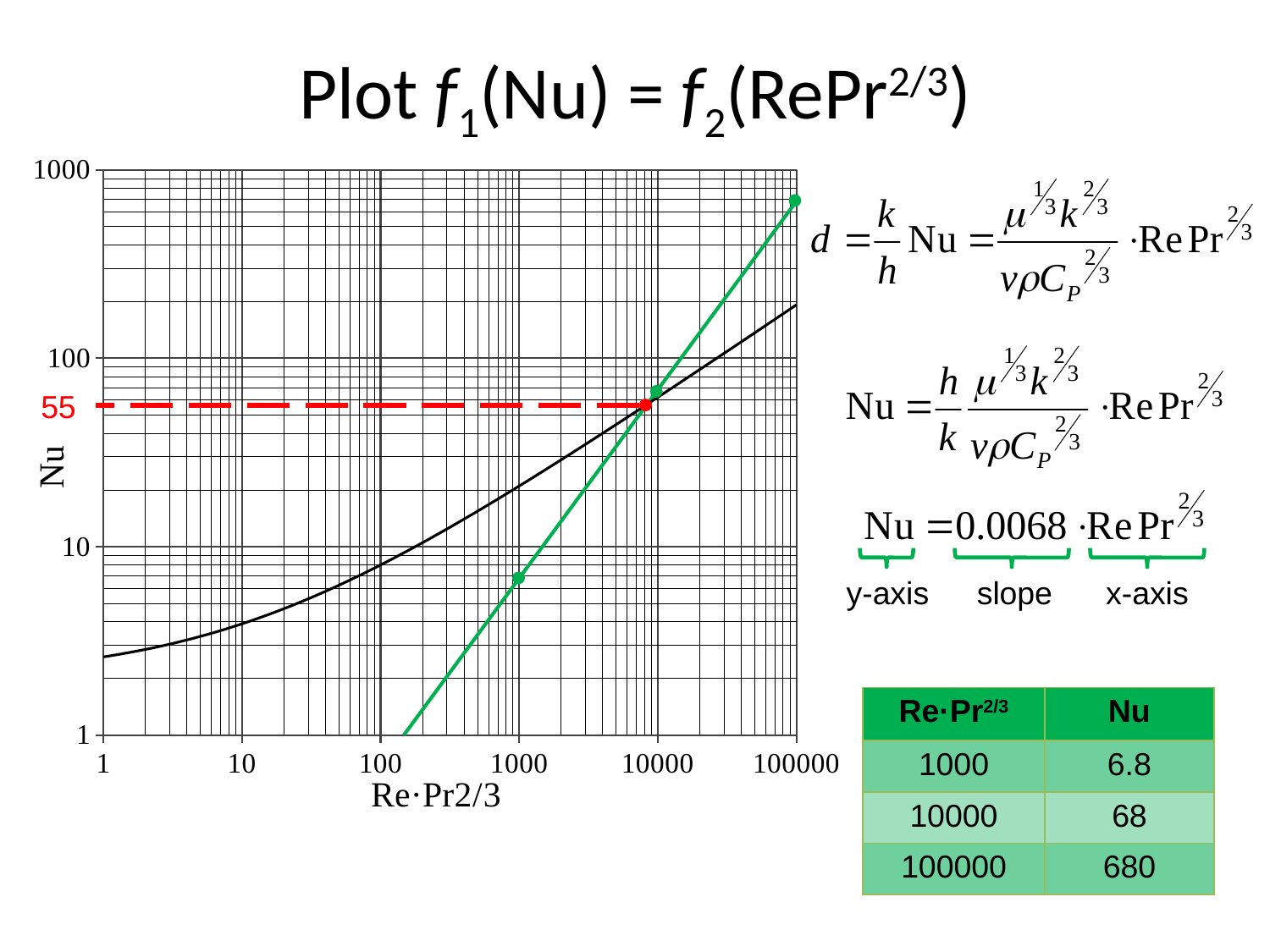
Does the green line rise or fall as Re·Pr2/3 increases? rises What is the Nu value of the green line at Re·Pr2/3 = 100000? 680 What is the label of the x axis of the chart? Re·Pr2/3 How many marked data points are on the green line? 3 At what Nu value is the red dashed horizontal line drawn? 55 What kind of chart is shown on the slide? line chart What is the difference between the Nu values of the green line at Re·Pr2/3 = 100000 and at Re·Pr2/3 = 10000? 612 What is the Nu value of the green line at Re·Pr2/3 = 1000? 6.8 Is the value of the black curve at Re·Pr2/3 = 100000 greater or less than 100? greater What is the Nu value of the green line at Re·Pr2/3 = 10000? 68 What is the label of the y axis of the chart? Nu At Re·Pr2/3 = 1000, which is higher, the black curve or the green line? the black curve